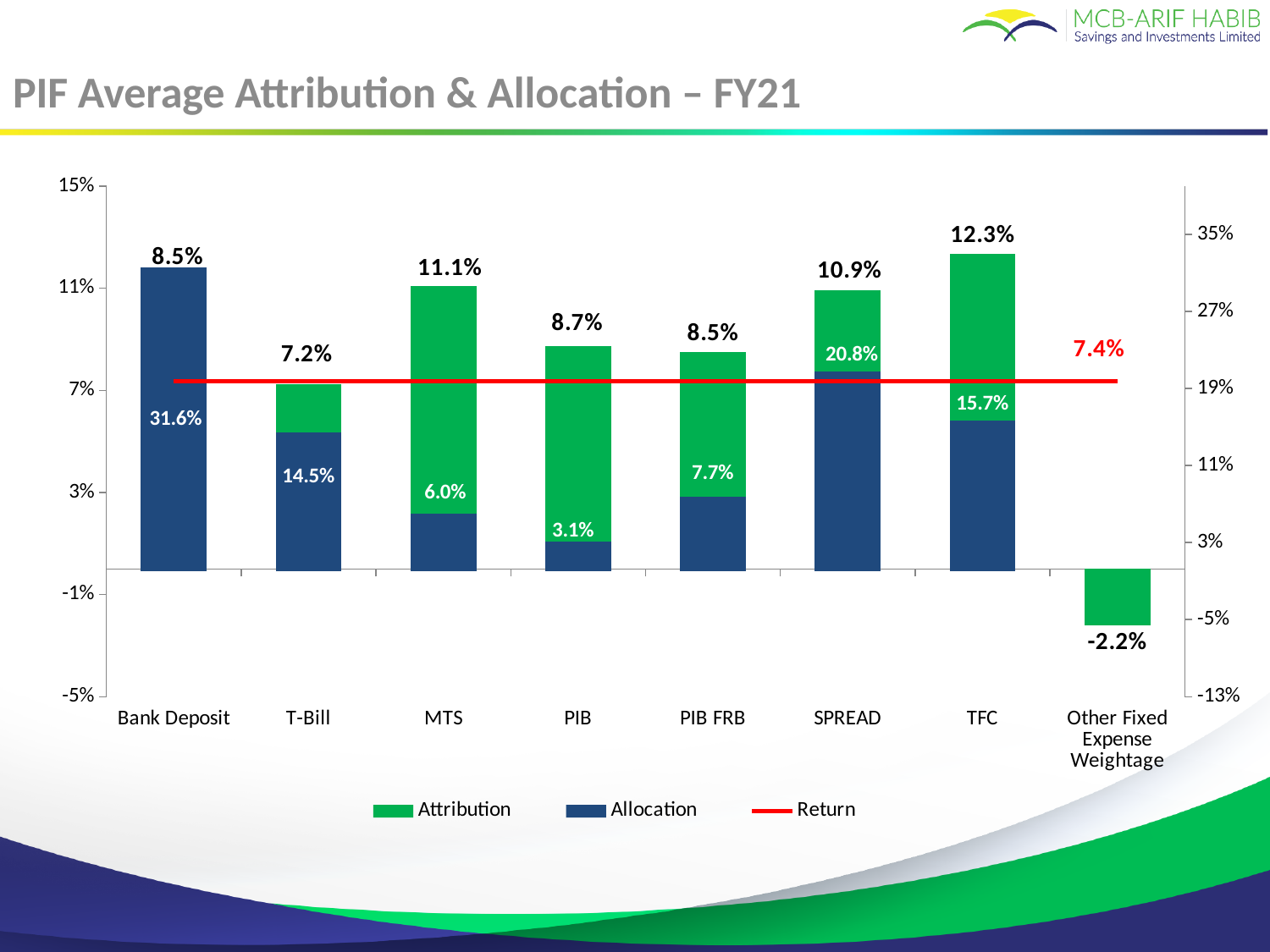
Which category has the lowest Allocation value? PIB What is the Return value shown by the red line? 7.4% What is the difference between the Attribution values for TFC and T-Bill? 5.1% What is the Attribution value for TFC? 12.3% Which has a larger Allocation value, SPREAD or TFC? SPREAD How many series does the legend list? 3 How many categories are shown on the x axis? 8 What kind of chart is shown on the slide? Bar chart with a line What is the Allocation value for Bank Deposit? 31.6% Which category has the lowest Attribution value? Other Fixed Expense Weightage What is the Attribution value for PIB FRB? 8.5% Which category has the highest Attribution value? TFC